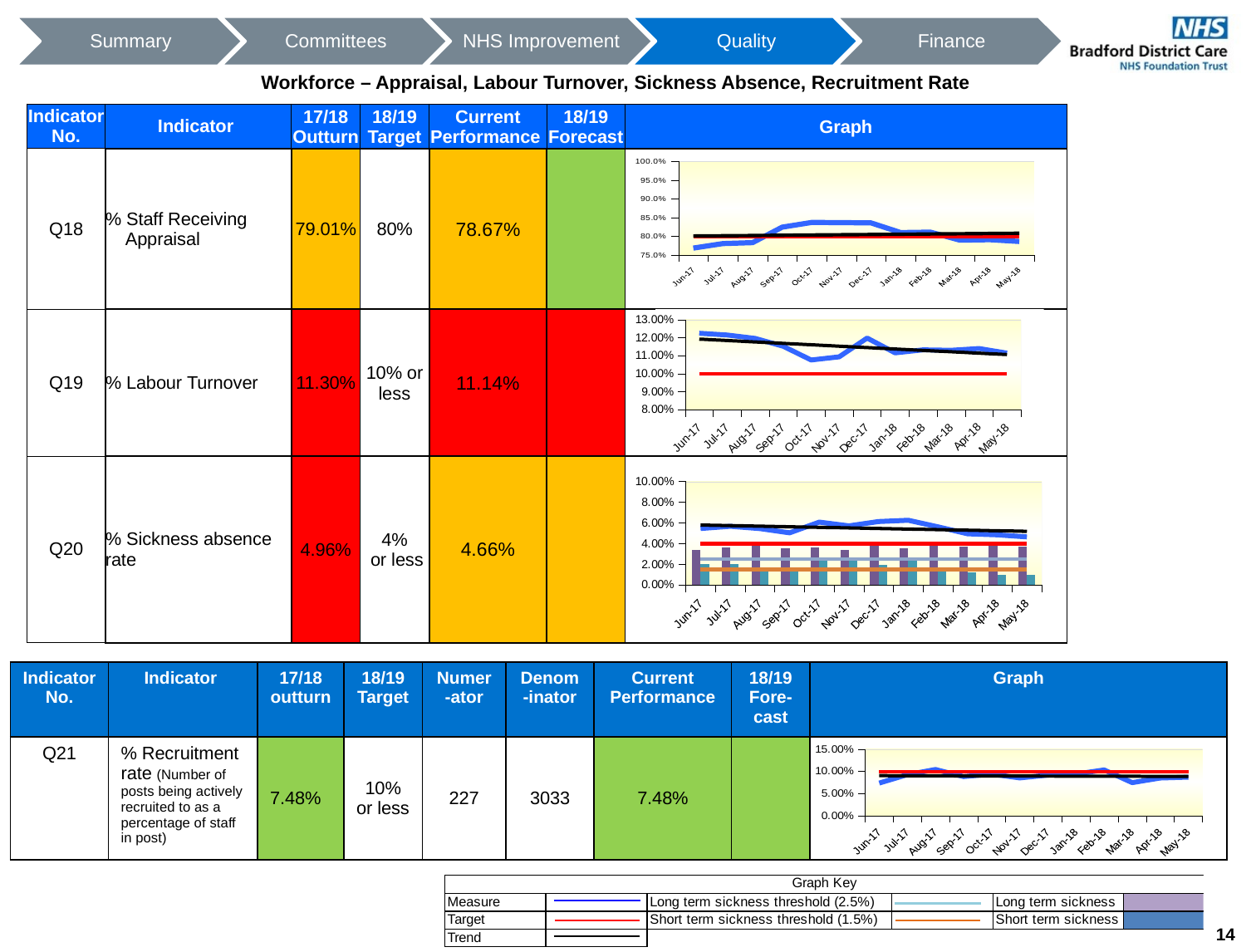
In the Q18 % Staff Receiving Appraisal chart, is the measure value for Jun-17 greater or less than 80.0%? less In the Q20 % Sickness absence rate chart, is the measure value for Jan-18 greater or less than 8.00%? less What kind of chart is shown for Q18 % Staff Receiving Appraisal? line chart In the Q20 % Sickness absence rate chart, is the measure value for Jun-17 greater or less than 4.00%? greater How many months are plotted on the x axis of the Q19 % Labour Turnover chart? 12 According to the Graph Key, what colour is the Target line in the charts? red According to the Graph Key, what colour is the Trend line in the charts? black What is the first month shown on the x axis of the Q21 % Recruitment rate chart? Jun-17 In the Q19 % Labour Turnover chart, does the measure line overall rise or fall from Jun-17 to May-18? fall